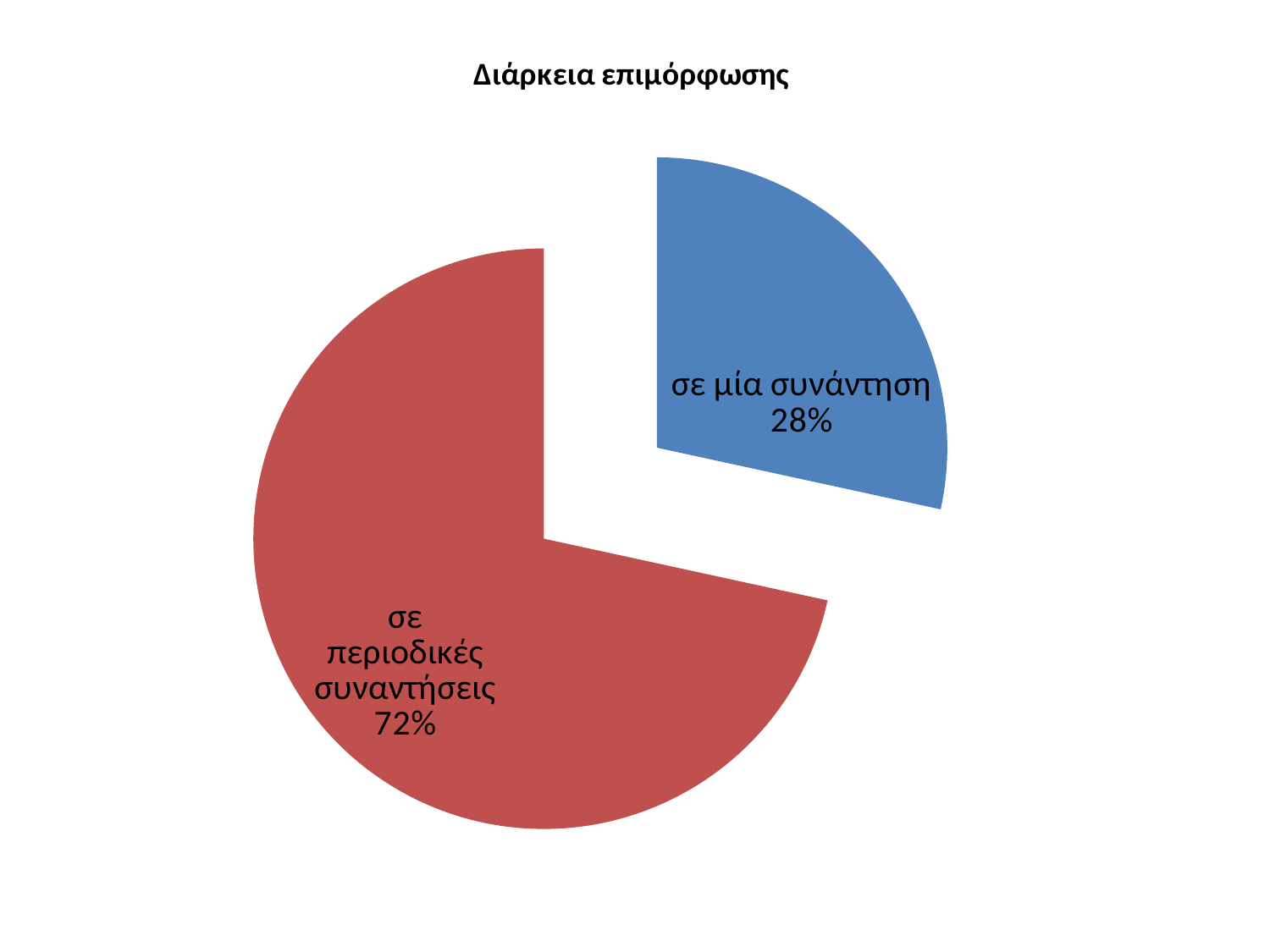
How many slices does the pie chart have? 2 What is the total of the two slice percentages shown? 100% What colour is the slice for "σε μία συνάντηση"? blue Which category has the largest share of the pie? σε περιοδικές συναντήσεις What is the title of the chart? Διάρκεια επιμόρφωσης What is the difference in percentage points between "σε περιοδικές συναντήσεις" and "σε μία συνάντηση"? 44 What share of the pie does "σε περιοδικές συναντήσεις" represent? 72% Which category has the smallest share of the pie? σε μία συνάντηση Which is larger: the share for "σε μία συνάντηση" or the share for "σε περιοδικές συναντήσεις"? σε περιοδικές συναντήσεις What type of chart is shown on the slide? pie chart What share of the pie does "σε μία συνάντηση" represent? 28%